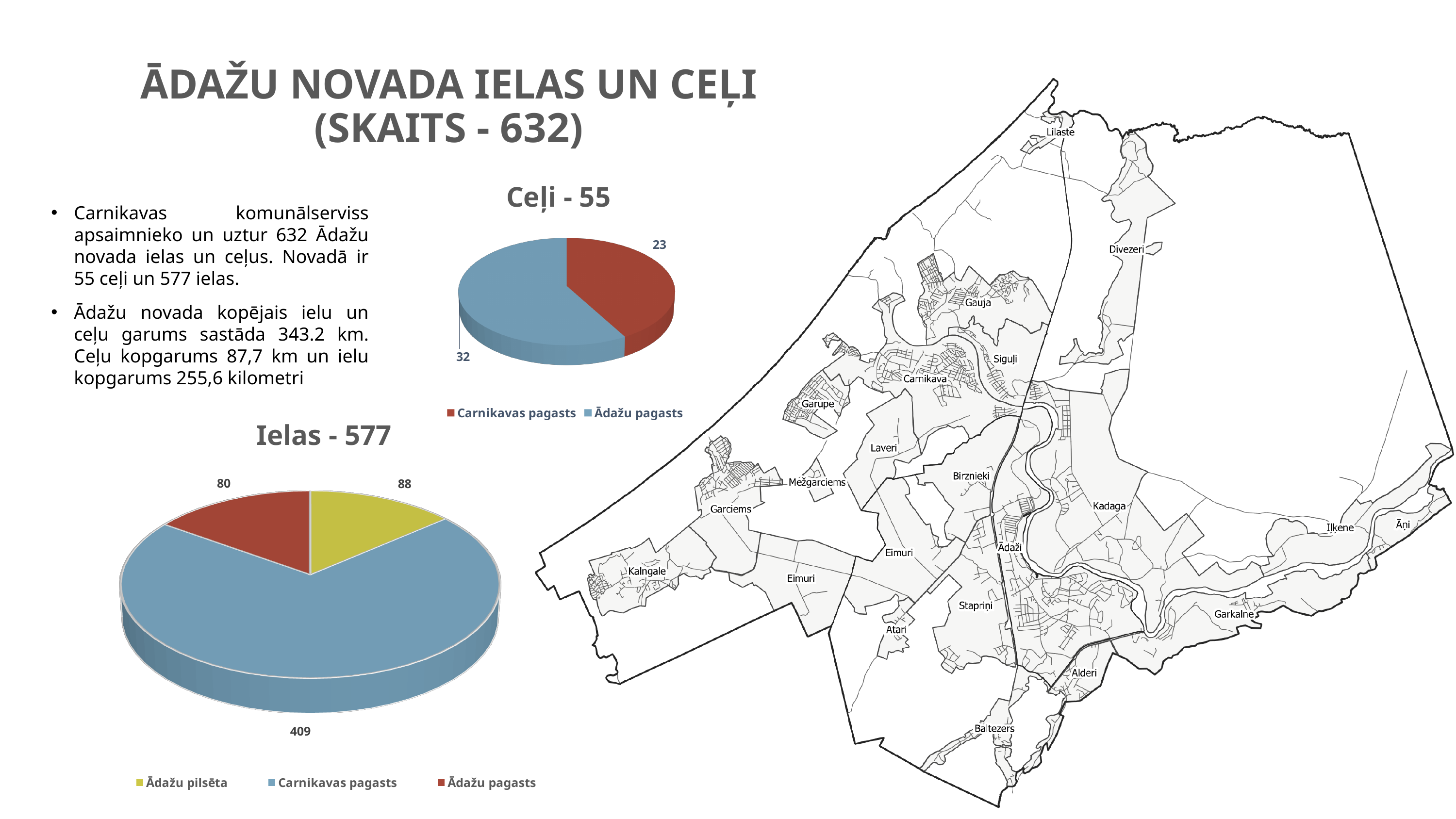
In the 'Ielas - 577' chart, what is the value for Carnikavas pagasts? 409 In the 'Ielas - 577' chart, what colour is the Ādažu pilsēta slice? Yellow In the 'Ceļi - 55' chart, which is larger: Carnikavas pagasts or Ādažu pagasts? Ādažu pagasts How many slices does the 'Ielas - 577' chart have? 3 In the 'Ceļi - 55' chart, what is the value for Ādažu pagasts? 32 In the 'Ielas - 577' chart, what is the difference between Ādažu pilsēta and Ādažu pagasts? 8 In the 'Ceļi - 55' chart, what is the value for Carnikavas pagasts? 23 In the 'Ceļi - 55' chart, what is the difference between Ādažu pagasts and Carnikavas pagasts? 9 In the 'Ielas - 577' chart, which category has the highest value? Carnikavas pagasts In the 'Ielas - 577' chart, what is the value for Ādažu pilsēta? 80 In the 'Ielas - 577' chart, which category has the lowest value? Ādažu pilsēta What type of chart is 'Ceļi - 55'? Pie chart